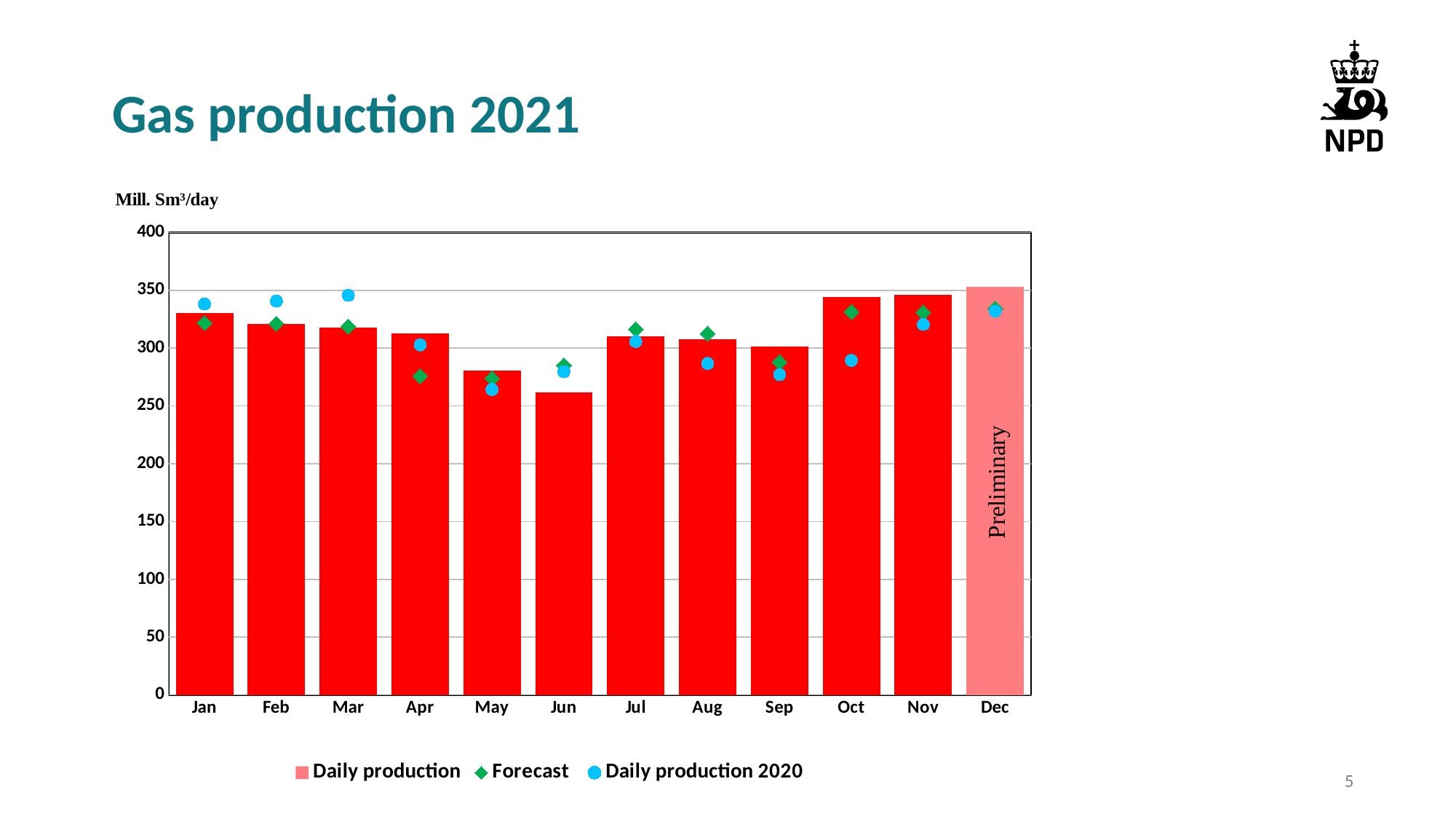
Is the daily production value for Jun greater or less than 300? less Do the daily production bars rise or fall from Jan to Jun? fall Which month has the lowest daily production bar? Jun What word is written on the Dec bar? Preliminary Is the daily production value for Jan greater or less than 300? greater Is the daily production value for May greater or less than 300? less Which month has the highest daily production bar? Dec What kind of chart is shown on the slide? bar chart How many series does the chart legend list? 3 How many months are shown on the x axis of the chart? 12 Which month has the larger daily production bar, Jan or Jun? Jan